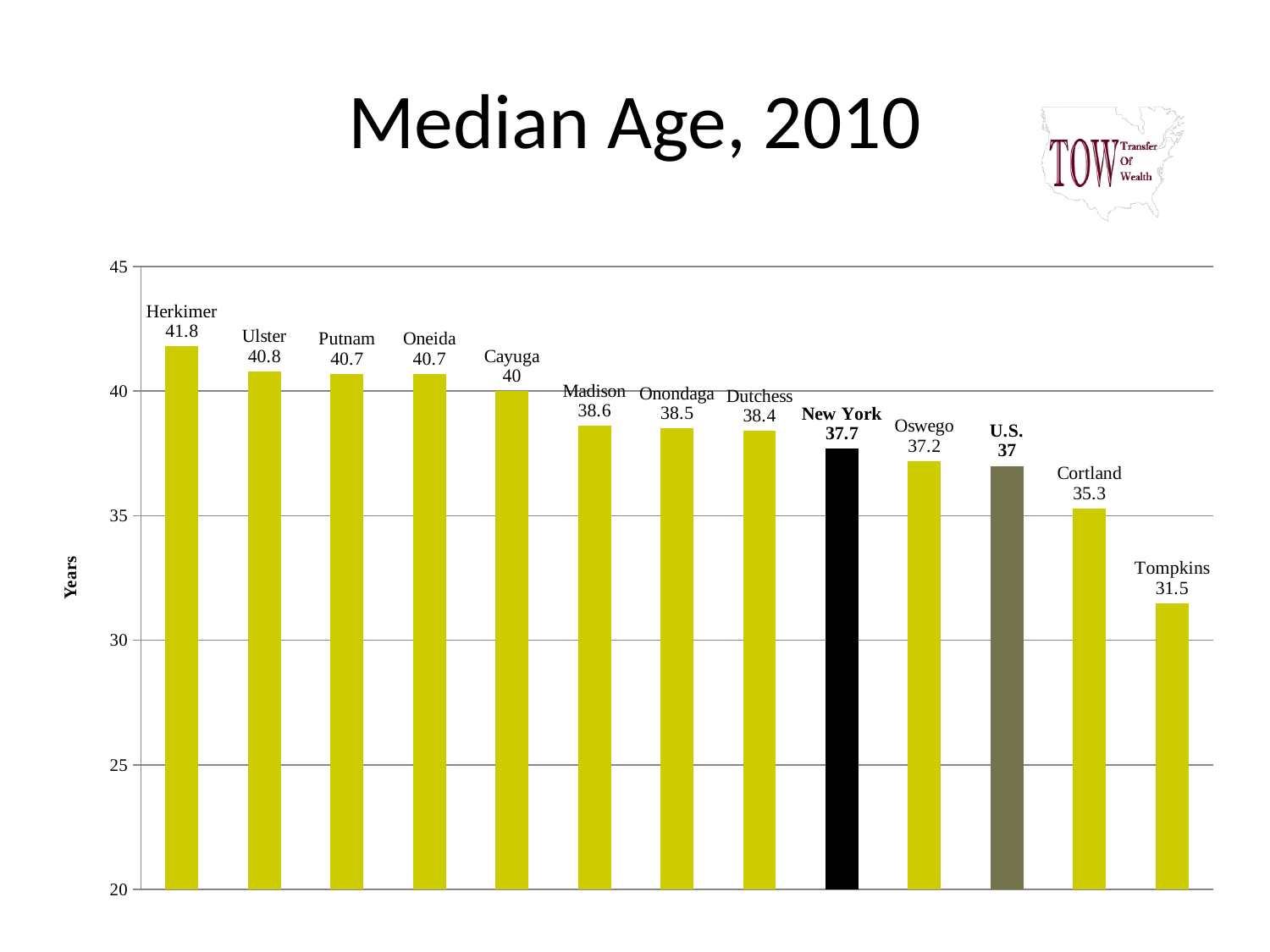
What is the median age shown for New York? 37.7 What is the difference between the median age of Herkimer and Tompkins? 10.3 What kind of chart is shown on the slide? bar chart Is the median age for Cortland greater or less than 35? greater Which category has the lowest median age? Tompkins Which category has the highest median age? Herkimer How many bars are shown in the chart? 13 What is the median age shown for Herkimer? 41.8 What is the label on the vertical axis of the chart? Years What is the median age shown for the U.S.? 37 Do the median age values rise or fall from left to right across the chart? fall Which has a higher median age, Oswego or Cortland? Oswego